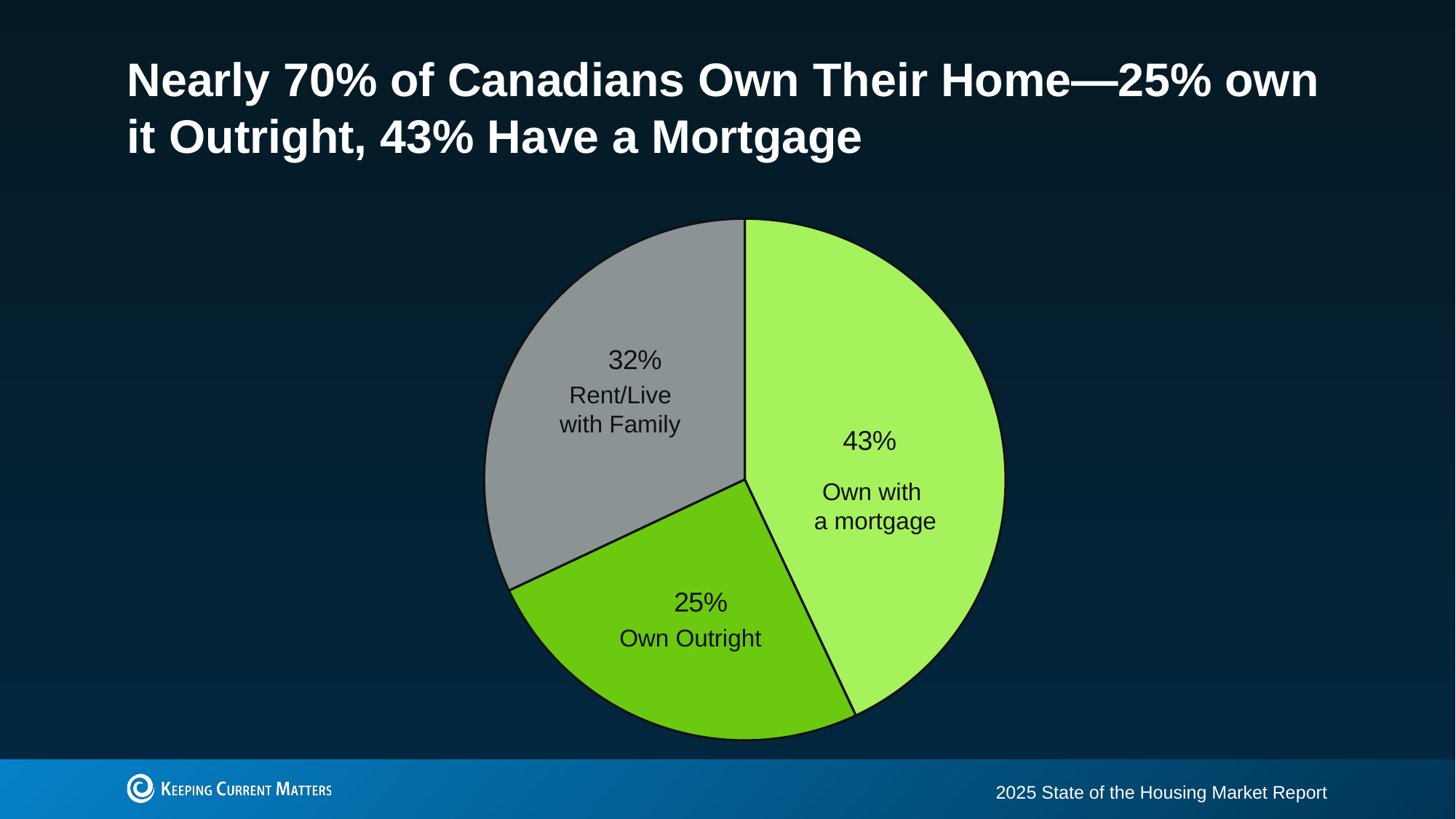
What share of Canadians own their home with a mortgage? 43% What colour is the Rent/Live with Family slice? Grey How many slices does the pie chart have? 3 What share of Canadians own their home outright? 25% What is the combined share of Canadians who own their home, either outright or with a mortgage? 68% Which slice of the pie is the largest? Own with a mortgage Which slice of the pie is the smallest? Own Outright What kind of chart is shown on the slide? Pie chart What is the difference between the share that rent/live with family and the share that own outright? 7% What share of Canadians rent or live with family? 32% What is the difference between the share that own with a mortgage and the share that own outright? 18% Which is larger: the share that rent/live with family or the share that own outright? Rent/Live with Family